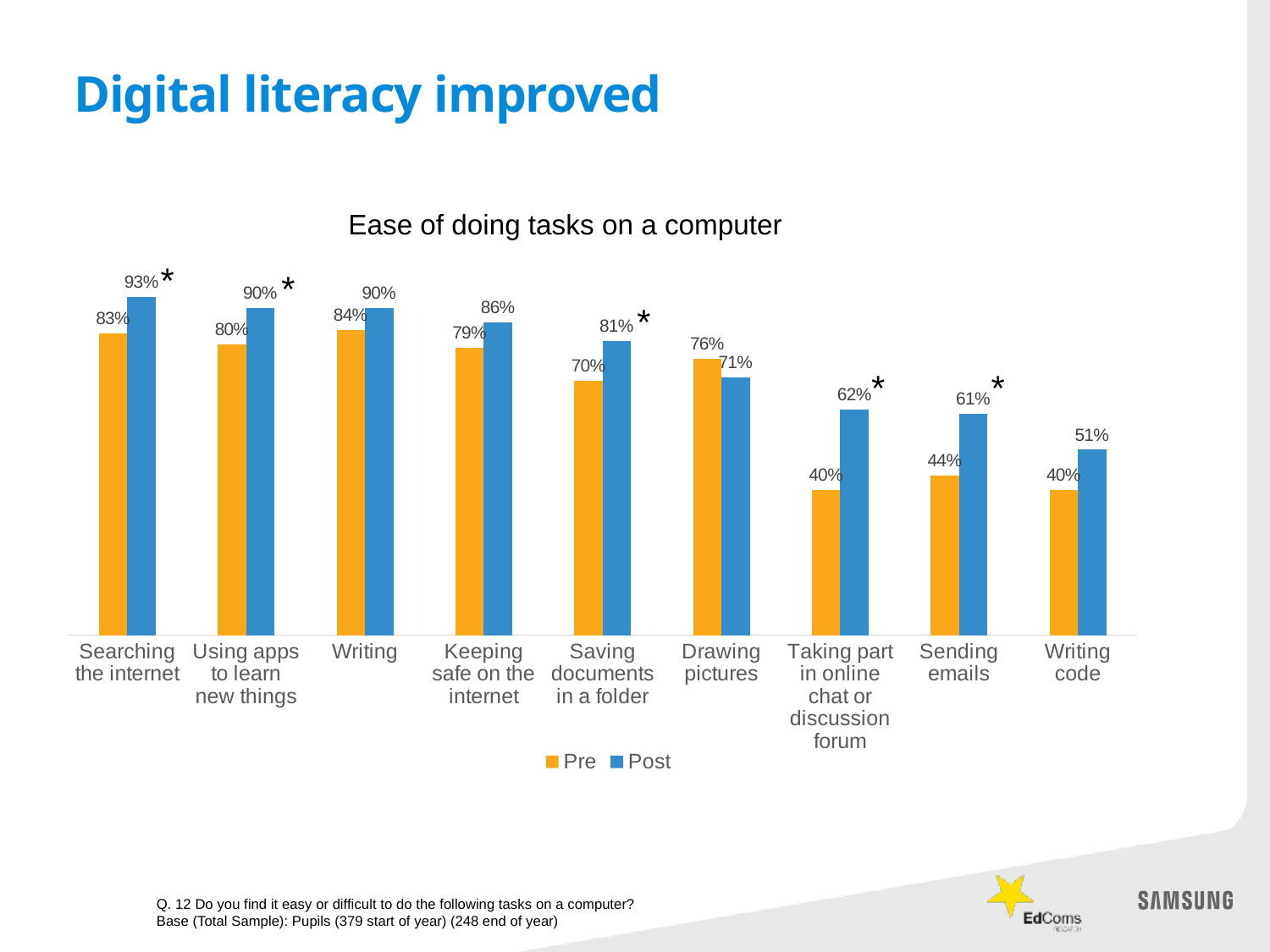
For Drawing pictures, which is larger, the Pre value or the Post value? Pre What is the difference between the Post and Pre values for Sending emails? 17% Which category has the highest Post value? Searching the internet What is the difference between the Post and Pre values for Taking part in online chat or discussion forum? 22% What is the Pre value for Taking part in online chat or discussion forum? 40% What kind of chart is shown on the slide? Bar chart Which category has the lowest Post value? Writing code How many task categories are shown on the x axis? 9 What is the Pre value for Drawing pictures? 76% How many series does the legend list? 2 What is the Post value for Searching the internet? 93% What is the title of the chart? Ease of doing tasks on a computer